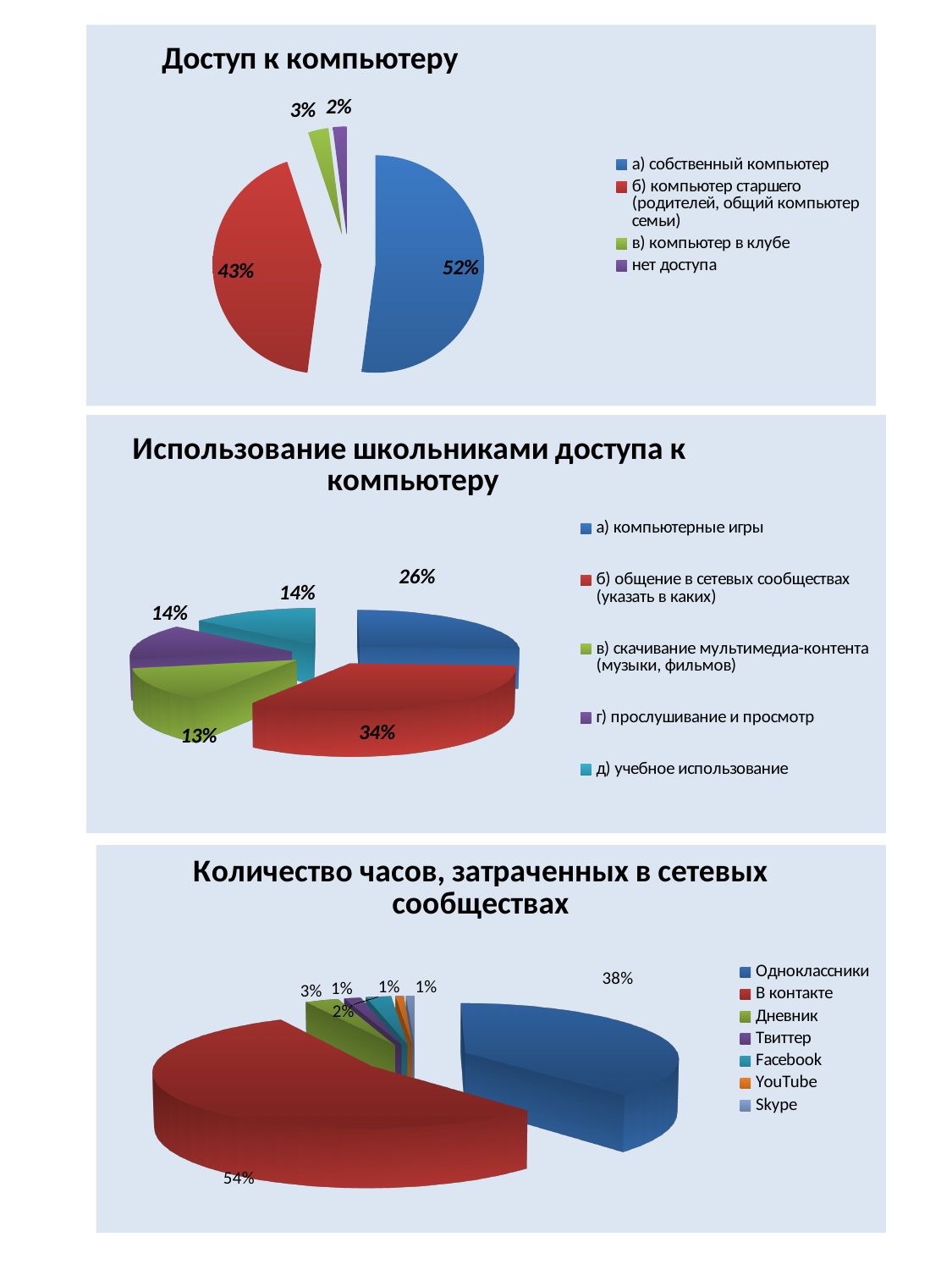
In the chart titled "Использование школьниками доступа к компьютеру", what percentage is shown for "б) общение в сетевых сообществах"? 34% In the chart titled "Использование школьниками доступа к компьютеру", what percentage is shown for "в) скачивание мультимедиа-контента"? 13% In the chart titled "Доступ к компьютеру", which category has the smallest share? нет доступа In the chart titled "Доступ к компьютеру", how many categories does the legend list? 4 In the chart titled "Использование школьниками доступа к компьютеру", how many categories does the legend list? 5 In the chart titled "Количество часов, затраченных в сетевых сообществах", which is larger, "Одноклассники" or "В контакте"? В контакте In the chart titled "Доступ к компьютеру", what is the difference in percentage points between "а) собственный компьютер" and "б) компьютер старшего"? 9 In the chart titled "Использование школьниками доступа к компьютеру", which category has the largest share? б) общение в сетевых сообществах In the chart titled "Доступ к компьютеру", what percentage is shown for "в) компьютер в клубе"? 3% In the chart titled "Количество часов, затраченных в сетевых сообществах", what percentage is shown for "В контакте"? 54% What type of chart is the bottom chart on the slide? pie chart In the chart titled "Доступ к компьютеру", what percentage is shown for "а) собственный компьютер"? 52%